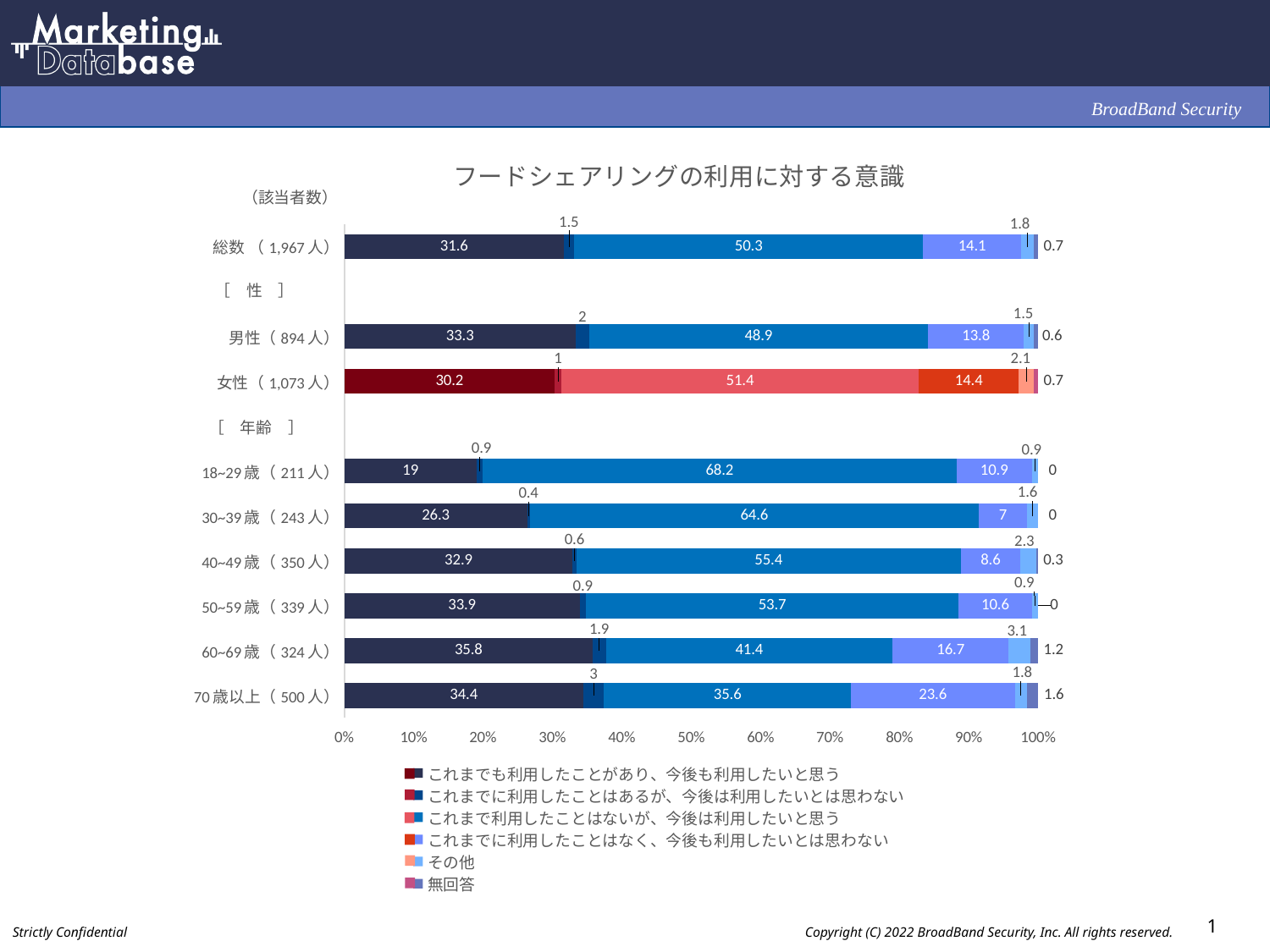
What is the 「無回答」 value for 30~39歳? 0 What is the 「その他」 value for 60~69歳? 3.1 What type of chart is shown on the slide? Stacked bar chart What is the difference between 男性 and 女性 for the 「これまでも利用したことがあり、今後も利用したいと思う」 segment? 3.1 What is the value of the 「これまで利用したことはないが、今後は利用したいと思う」 segment for 総数? 50.3 Which age group has the highest value for 「これまで利用したことはないが、今後は利用したいと思う」? 18~29歳 How many series does the legend list? 6 Which is larger for the 「これまで利用したことはないが、今後は利用したいと思う」 segment: 60~69歳 or 70歳以上? 60~69歳 What is the title of the chart? フードシェアリングの利用に対する意識 Which category has the lowest value for 「これまでも利用したことがあり、今後も利用したいと思う」? 18~29歳 How many category bars are plotted in the chart? 9 What is the value of the 「これまでに利用したことはなく、今後も利用したいとは思わない」 segment for 70歳以上? 23.6